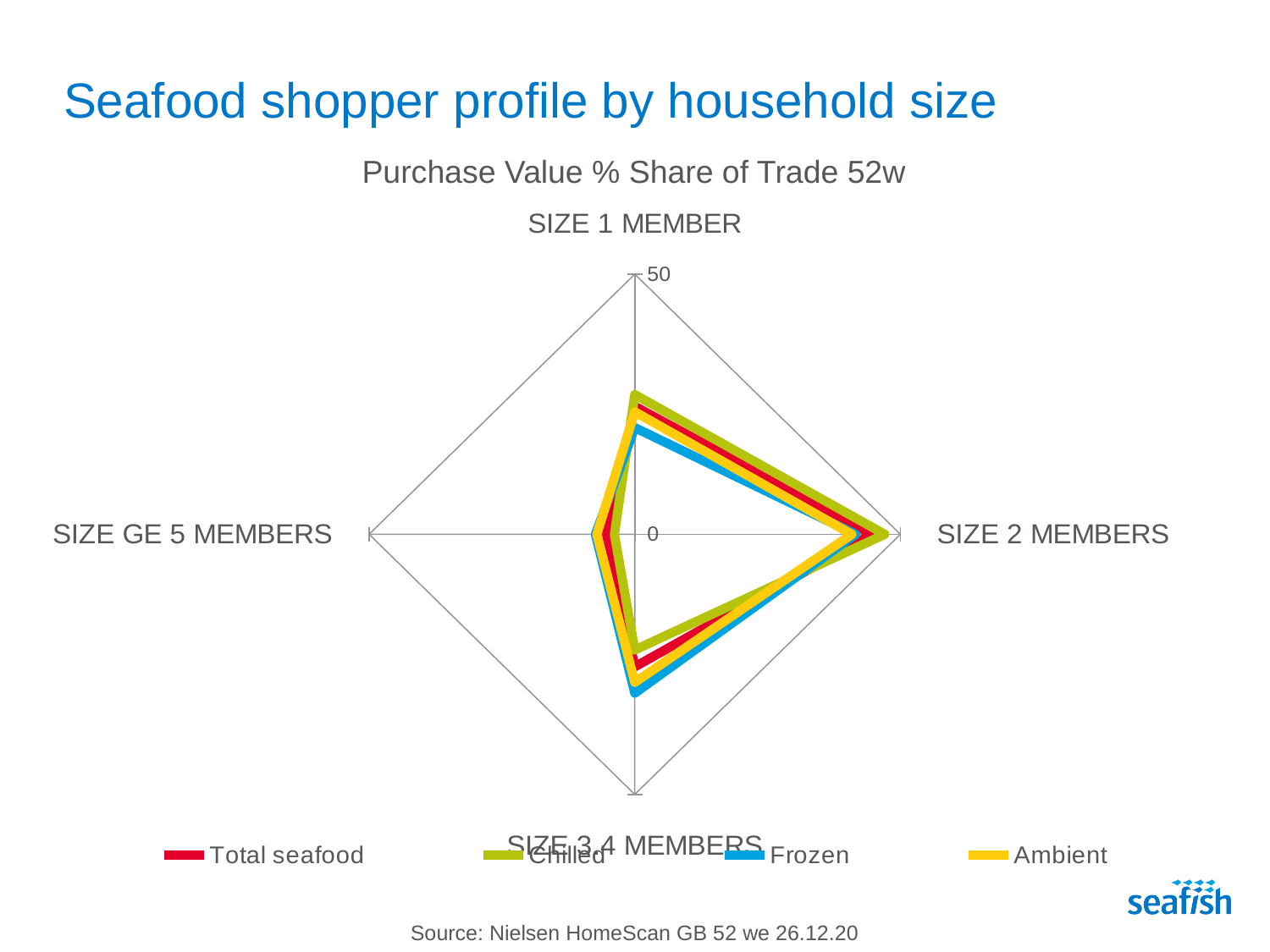
For Frozen, which category has the larger share: SIZE 1 MEMBER or SIZE 3,4 MEMBERS? SIZE 3,4 MEMBERS Which series is shown in blue in the legend? Frozen Which household size category has the lowest share of trade for Chilled? SIZE GE 5 MEMBERS How many series does the legend list? 4 What is the title of the chart? Purchase Value % Share of Trade 52w What kind of chart is shown on the slide? Radar chart Which household size category has the highest share of trade for Total seafood? SIZE 2 MEMBERS At SIZE 3,4 MEMBERS, which series has the larger share: Frozen or Chilled? Frozen How many household size categories are plotted on the radar chart? 4 Is the Ambient value for SIZE 1 MEMBER greater or less than 50? less Is the Total seafood value for SIZE GE 5 MEMBERS greater or less than 50? less At SIZE 1 MEMBER, which series has the larger share: Chilled or Frozen? Chilled